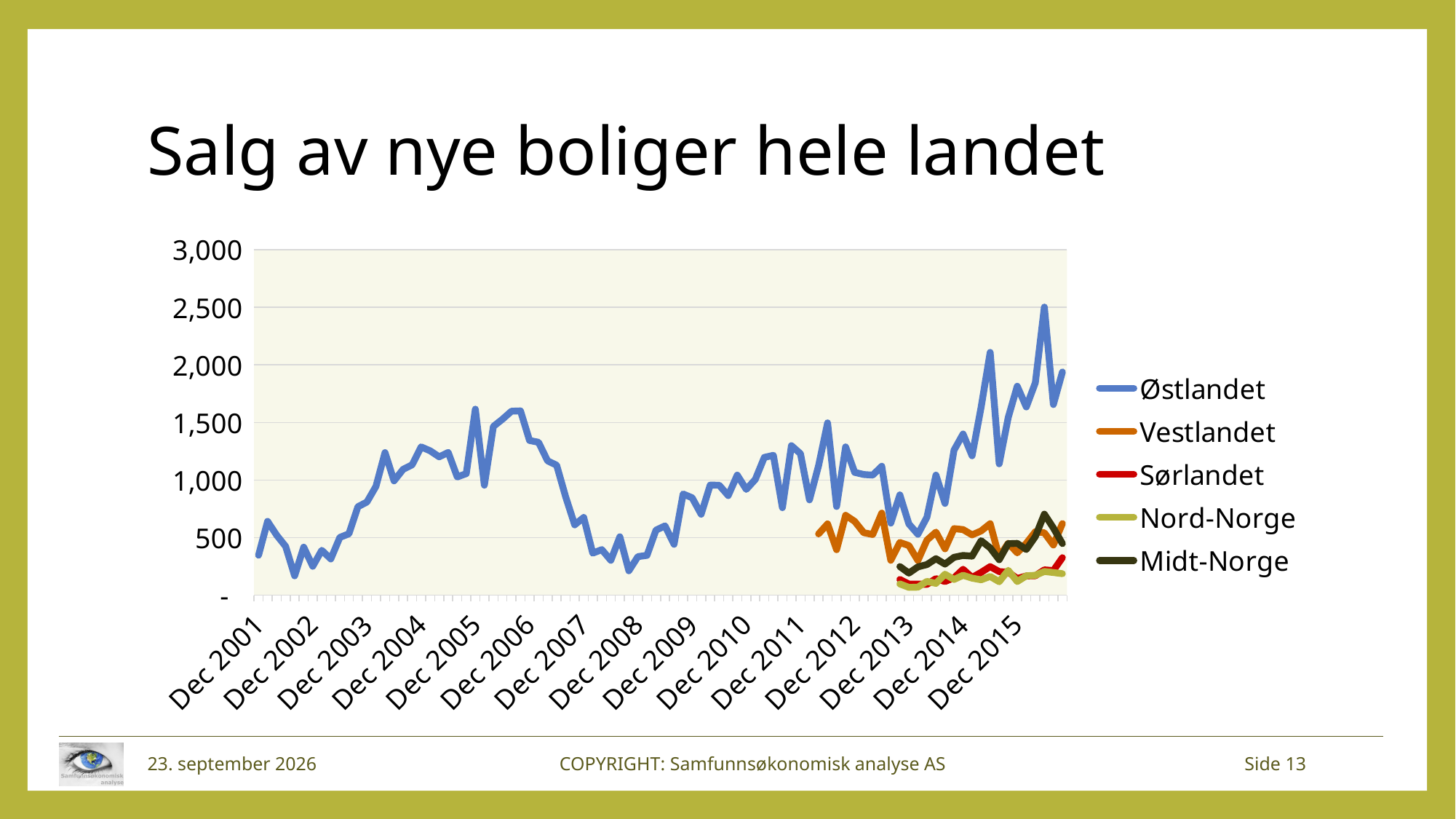
Is the highest value for Vestlandet greater or less than 1,000? less What kind of chart is shown on the slide? Line chart How many year labels are shown on the x axis? 15 Is the highest value for Midt-Norge greater or less than 1,000? less Which series is shown in blue in the legend? Østlandet Does the Østlandet series generally rise or fall between Dec 2013 and Dec 2015? Rise How many series does the legend list? 5 Which series reaches the highest value on the chart? Østlandet What is the title of the chart on the slide? Salg av nye boliger hele landet Is the value for Østlandet at Dec 2001 greater or less than 500? less At Dec 2015, which is larger: the value for Østlandet or the value for Vestlandet? Østlandet